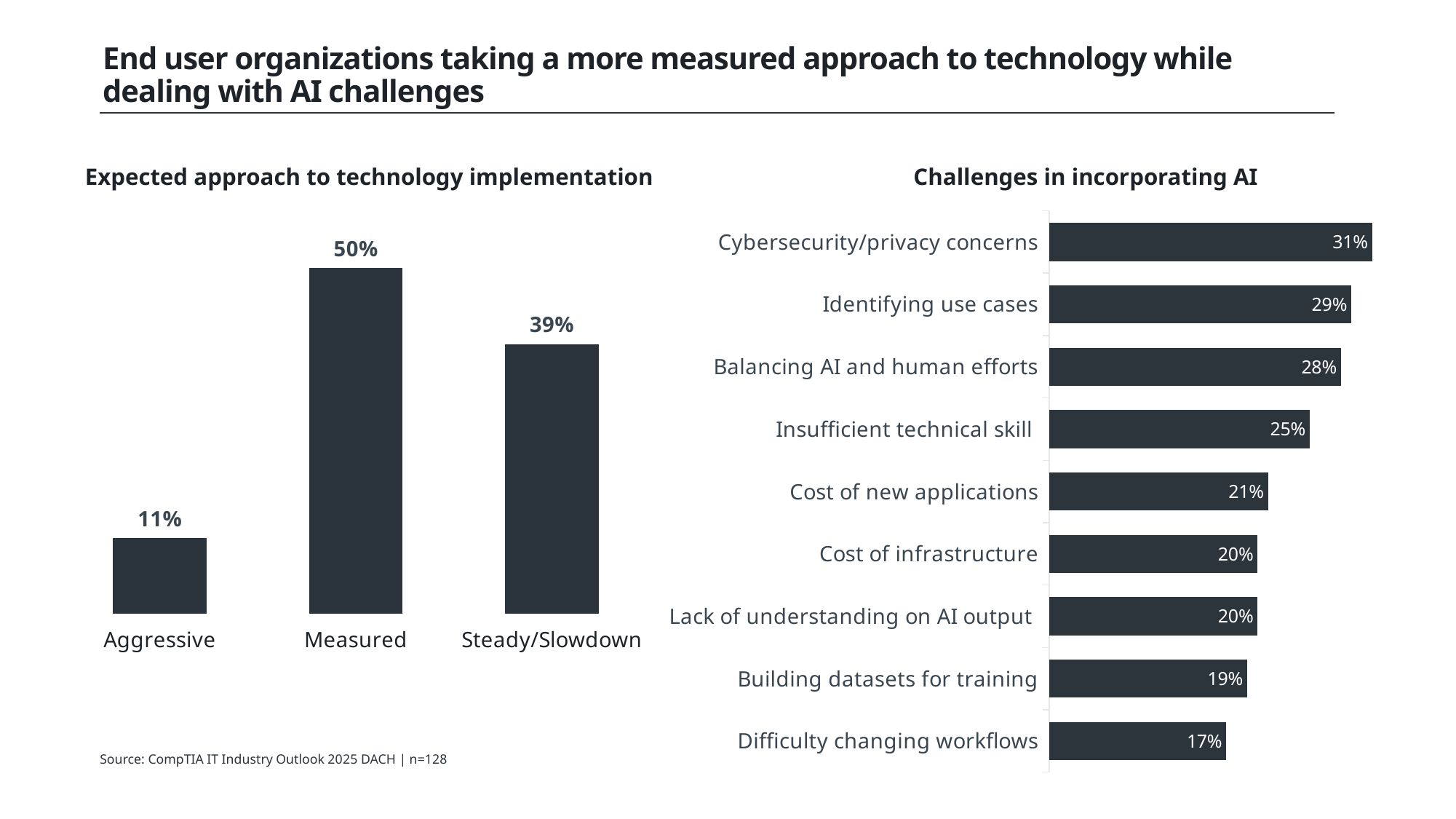
What kind of chart is 'Expected approach to technology implementation'? Bar chart In the 'Challenges in incorporating AI' chart, how many challenges are listed? 9 In the 'Challenges in incorporating AI' chart, which challenge has the highest value? Cybersecurity/privacy concerns In the 'Expected approach to technology implementation' chart, what is the value for Measured? 50% In the 'Expected approach to technology implementation' chart, which category has the lowest value? Aggressive In the 'Challenges in incorporating AI' chart, which challenge has the lowest value? Difficulty changing workflows In the 'Challenges in incorporating AI' chart, what is the difference between Cybersecurity/privacy concerns and Building datasets for training? 12% What is the source cited at the bottom of the slide? CompTIA IT Industry Outlook 2025 DACH | n=128 In the 'Expected approach to technology implementation' chart, how many categories are shown? 3 In the 'Challenges in incorporating AI' chart, what is the value for Insufficient technical skill? 25% In the 'Expected approach to technology implementation' chart, what is the difference between Measured and Steady/Slowdown? 11% In the 'Challenges in incorporating AI' chart, which is larger: Identifying use cases or Cost of new applications? Identifying use cases